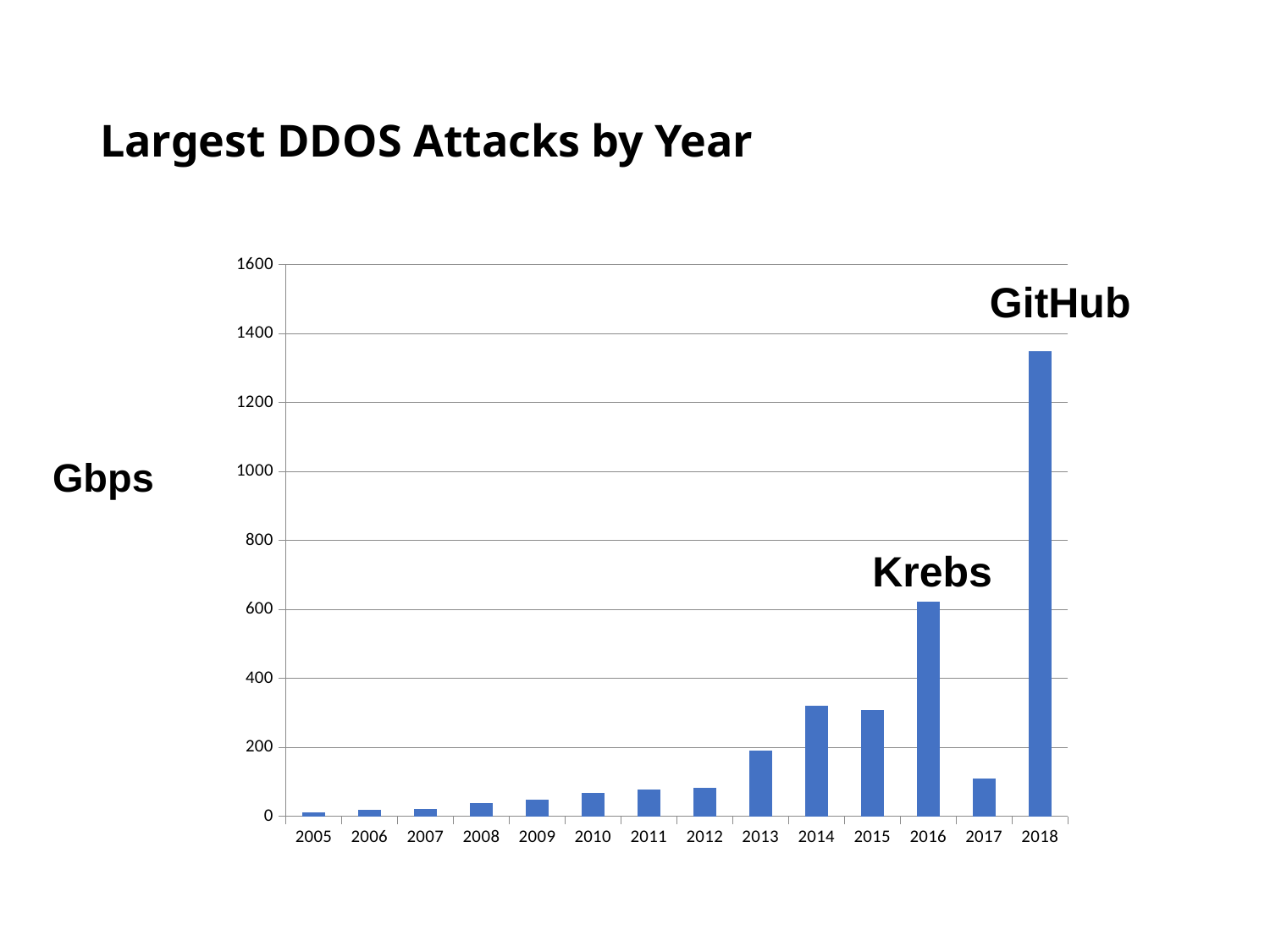
Is the value for 2018 greater or less than 1200? greater What kind of chart is shown on the slide? bar chart Which year has the highest value in the chart? 2018 Is the value for 2014 greater or less than 200? greater Which label is placed above the 2016 bar in the chart? Krebs Do the values rise or fall from 2005 to 2012? rise How many years are shown on the x axis of the chart? 14 Which year has the larger value, 2016 or 2017? 2016 What is the title of the chart? Largest DDOS Attacks by Year Is the value for 2017 greater or less than 200? less Which year has the lowest value in the chart? 2005